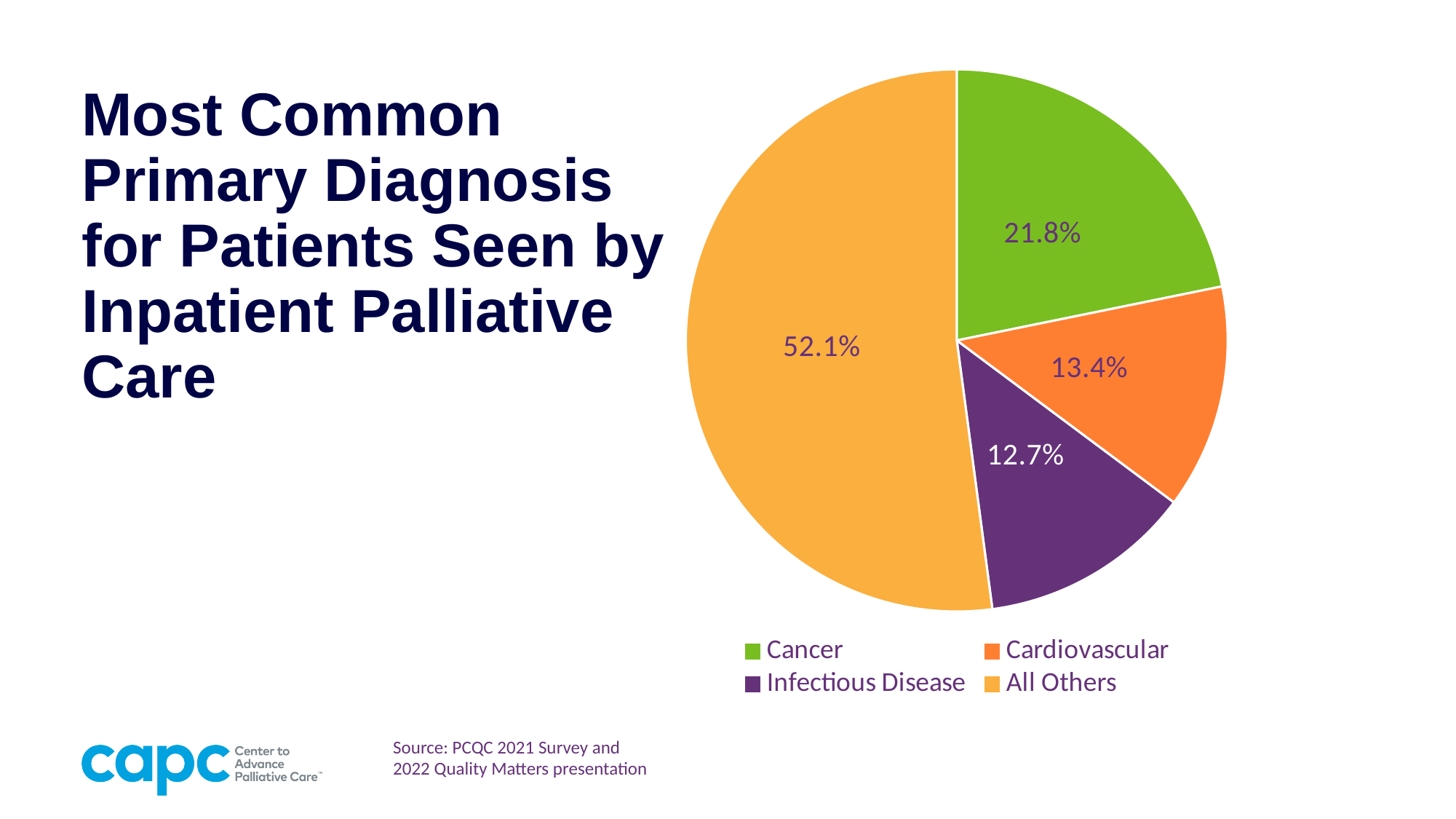
What is the combined share of Cancer and Cardiovascular? 35.2% Which category has the smallest slice of the pie? Infectious Disease What share of the pie is labelled All Others? 52.1% How many slices does the pie chart have? 4 What colour is the Cardiovascular slice? Orange What is the difference in percentage points between the Cancer slice and the Cardiovascular slice? 8.4 What share of patients have Cardiovascular as their primary diagnosis? 13.4% Which category has the largest slice of the pie? All Others What share of patients have Infectious Disease as their primary diagnosis? 12.7% Which is larger, the Cancer slice or the Infectious Disease slice? Cancer What kind of chart is shown on the slide? Pie chart What share of patients have Cancer as their primary diagnosis? 21.8%